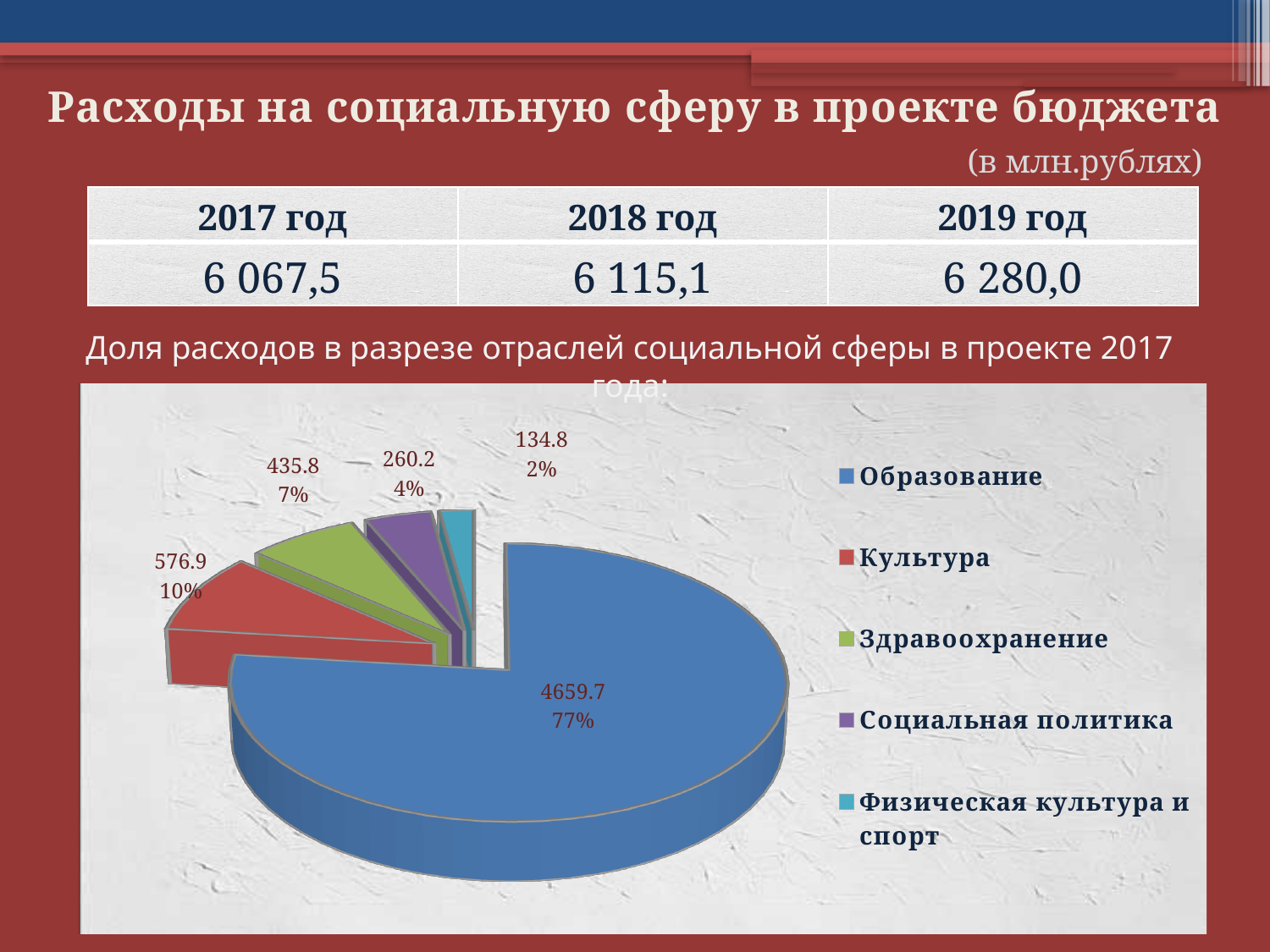
What is the difference between the values for Культура and Здравоохранение in the pie chart? 141.1 What share of the pie does Образование have? 77% How many entries does the legend of the pie chart list? 5 What is the value shown for Культура in the pie chart? 576.9 Which category has the largest slice in the pie chart? Образование What is the value shown for Здравоохранение in the pie chart? 435.8 How many slices does the pie chart have? 5 What is the value shown for Образование in the pie chart? 4659.7 What share of the pie does Физическая культура и спорт have? 2% What kind of chart is shown on the slide? pie chart What is the value shown for Социальная политика in the pie chart? 260.2 Which category has the smallest slice in the pie chart? Физическая культура и спорт